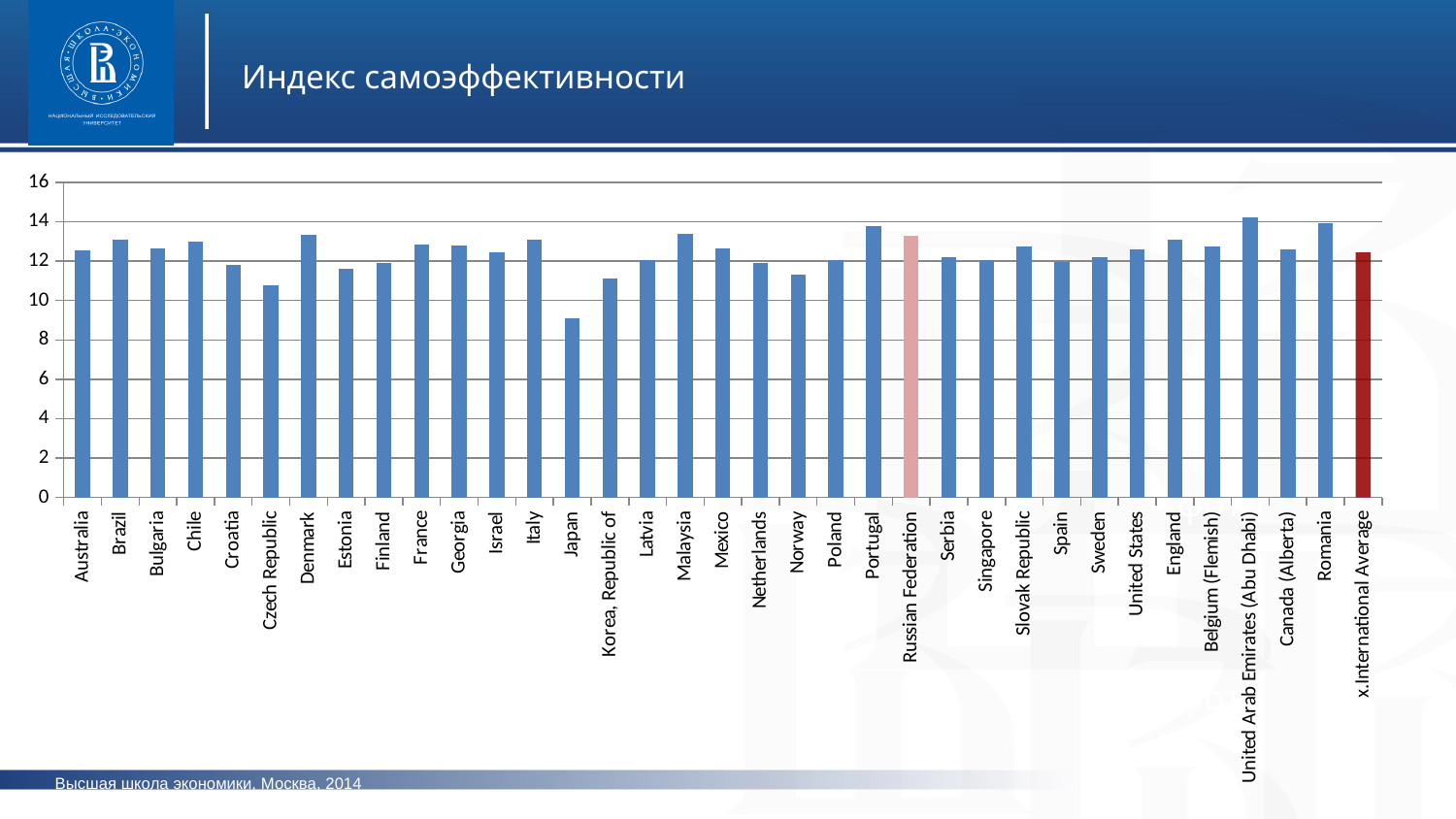
What is the title of the chart? Индекс самоэффективности Which has the larger value, Japan or Denmark? Denmark Is the value for Japan greater or less than 10? less How many categories are plotted along the x axis? 35 Which country has the lowest value in the chart? Japan Is the value for Korea, Republic of greater or less than 12? less Is the value for Russian Federation greater or less than 12? greater What kind of chart is shown on the slide? bar chart Which country's bar is highlighted in a different (pink) colour from the other blue bars? Russian Federation Which has the larger value, Croatia or Malaysia? Malaysia